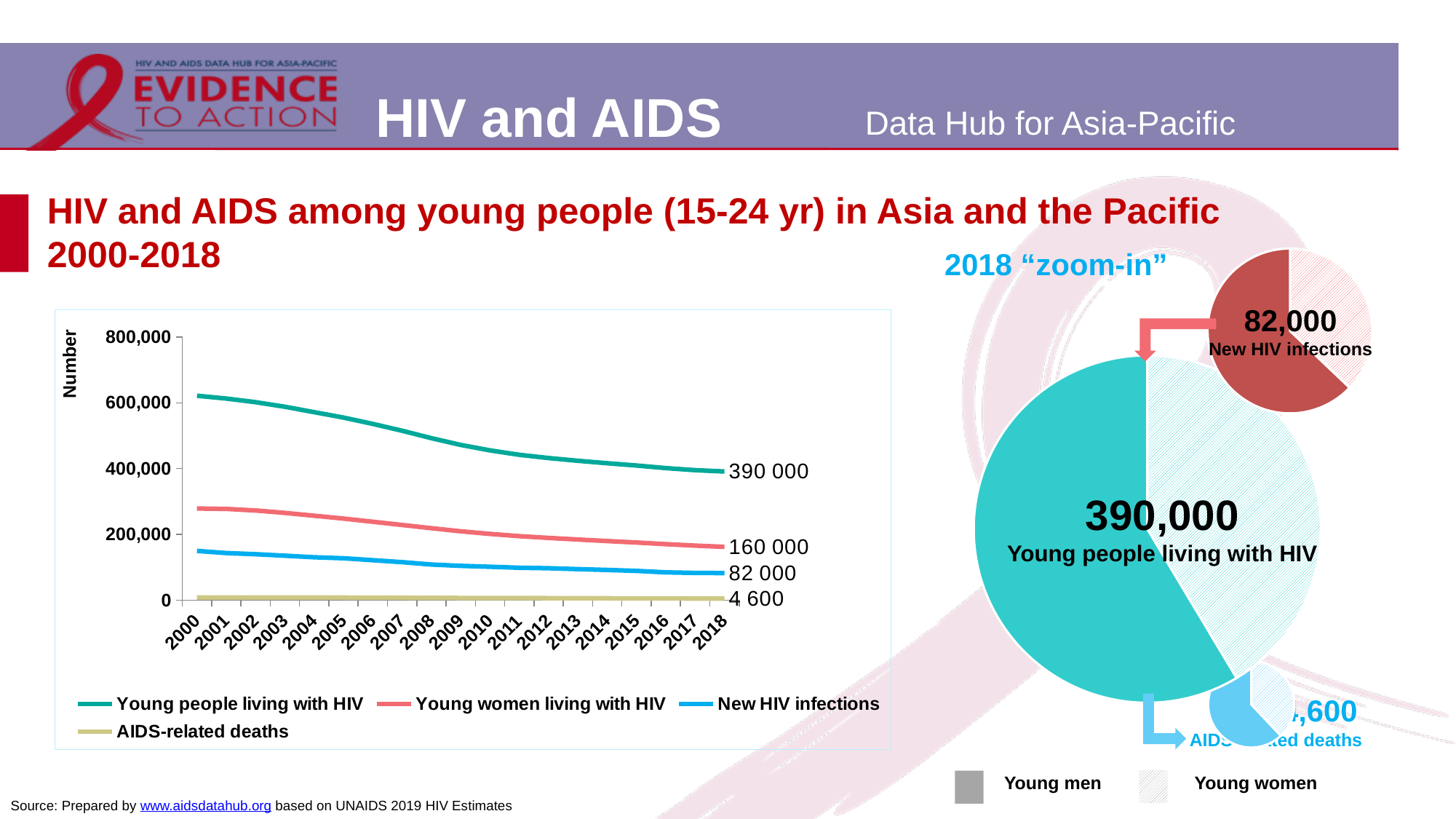
In the line chart, what is the value for AIDS-related deaths in 2018? 4 600 In the line chart, which series has the lowest value in 2018? AIDS-related deaths In the line chart, what is the value for New HIV infections in 2018? 82 000 In the line chart, what is the value for Young people living with HIV in 2018? 390 000 In the line chart, what is the difference between Young people living with HIV and Young women living with HIV in 2018? 230 000 In the line chart, is the value for Young women living with HIV in 2000 greater or less than 200,000? greater What type of chart is the chart on the left of the slide? line chart In the line chart, how many years are shown on the x axis? 19 In the 2018 "zoom-in" pie charts on the right, what is the number of New HIV infections? 82,000 In the line chart, what is the value for Young women living with HIV in 2018? 160 000 In the line chart, how many series does the legend list? 4 In the line chart, does the number of Young people living with HIV rise or fall from 2000 to 2018? fall